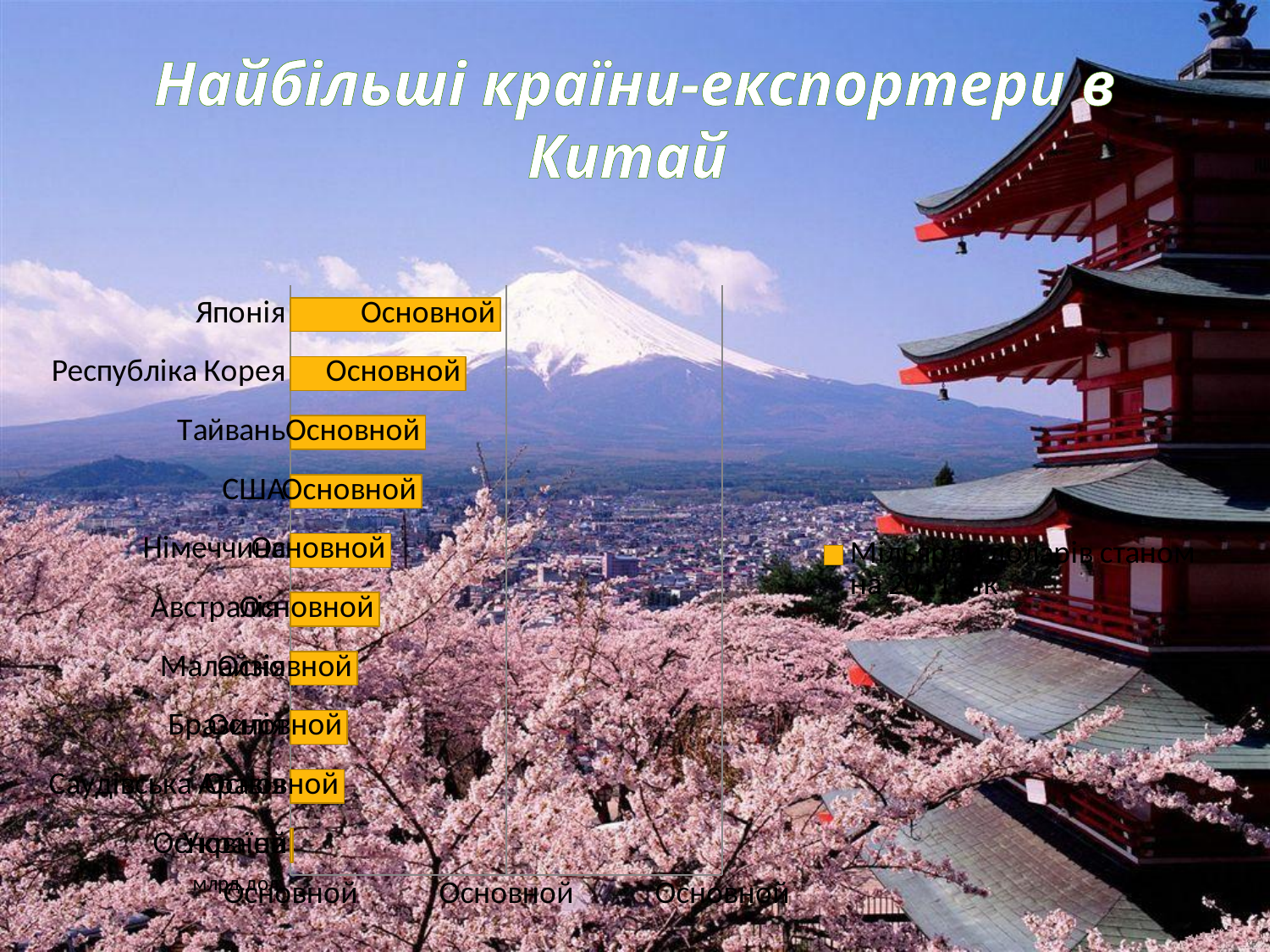
What kind of chart is shown on the slide? bar chart Which has the larger value, Німеччина or Малайзія? Німеччина Which has the larger value, Республіка Корея or Бразилія? Республіка Корея Which has the larger value, Японія or Республіка Корея? Японія What is the title of the slide containing the chart? Найбільші країни-експортери в Китай What colour are the bars in the chart? orange How many data series does the chart have? 1 Which country has the longest bar in the chart? Японія Do the bar lengths increase or decrease going from the top of the chart to the bottom? decrease How many countries (bars) are plotted in the chart? 10